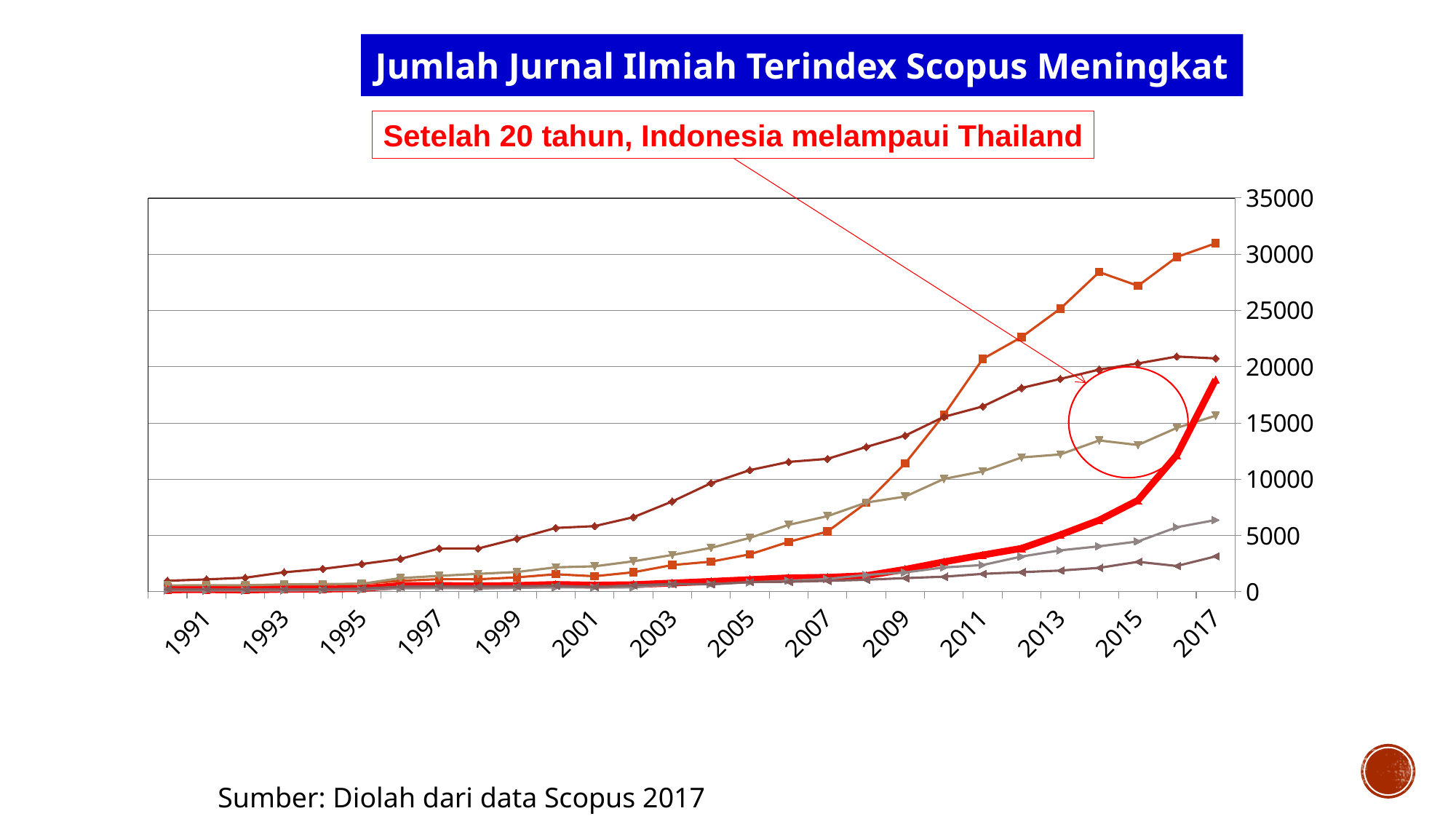
Is the value of the thick red line in 2017 greater or less than 15000? greater Is the value of the orange line with square markers in 2015 greater or less than 25000? greater What is the highest value shown on the vertical axis of the chart? 35000 What kind of chart is shown on the slide? Line chart Is the value of the orange line with square markers in 2017 greater or less than 30000? greater Which line has the highest value in 2017? The orange line with square markers How many year labels are shown along the x axis of the chart? 14 What is the title of the chart on the slide? Jumlah Jurnal Ilmiah Terindex Scopus Meningkat In 2017, which is higher: the thick red line or the tan line with triangle markers? The thick red line Does the thick red line rise or fall from 1991 to 2017? Rise